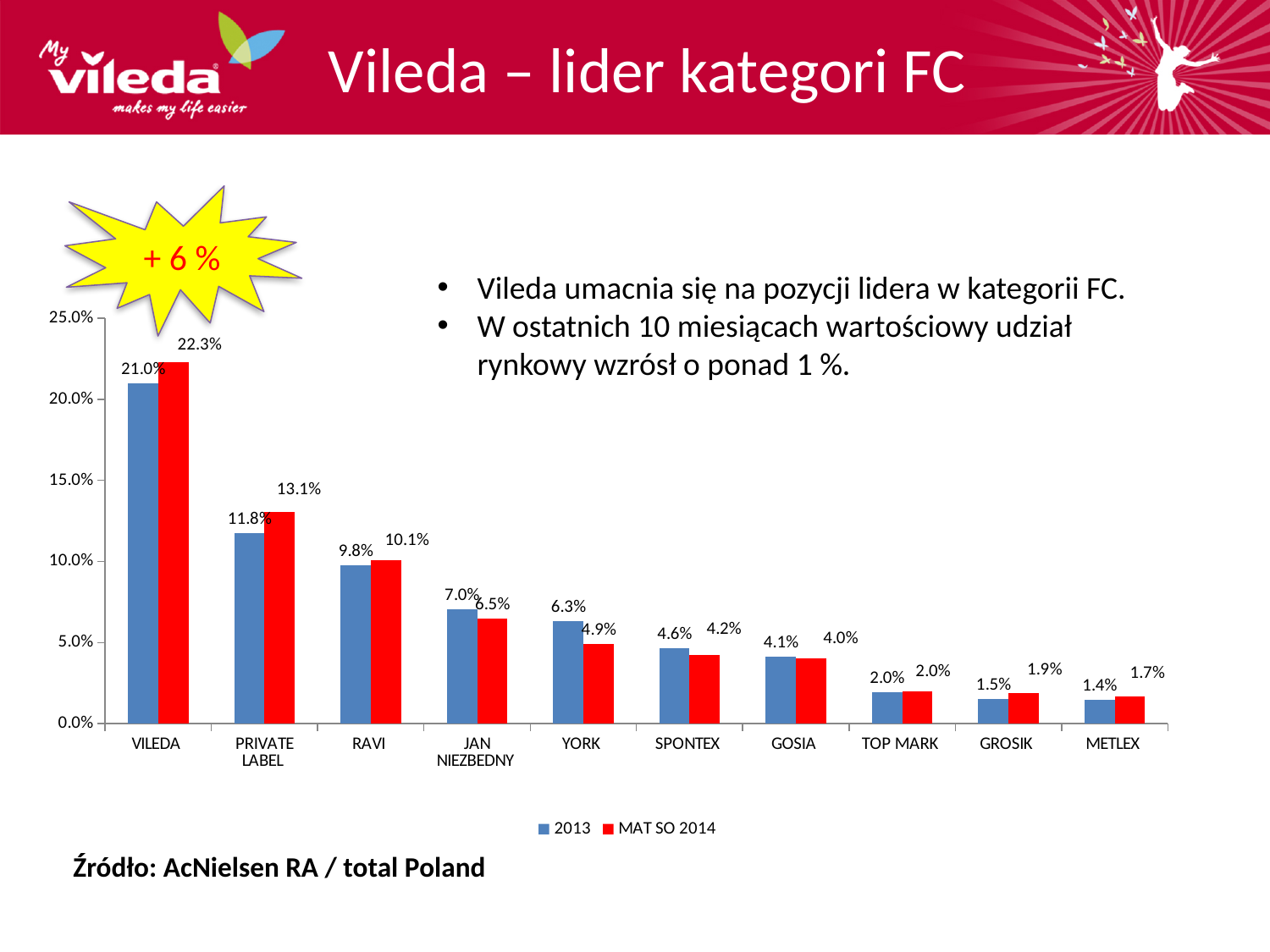
What is the 2013 value for PRIVATE LABEL? 11.8% What is the difference between the MAT SO 2014 and 2013 values for VILEDA? 1.3% What are the two series named in the legend? 2013 and MAT SO 2014 Which category has the lowest 2013 value? METLEX Which category has the highest MAT SO 2014 value? VILEDA What is the MAT SO 2014 value for VILEDA? 22.3% What is the MAT SO 2014 value for RAVI? 10.1% How many series does the legend list? 2 How many categories are shown on the x axis? 10 Which is larger for JAN NIEZBEDNY, the 2013 value or the MAT SO 2014 value? 2013 What kind of chart is shown on the slide? Bar chart What is the 2013 value for YORK? 6.3%